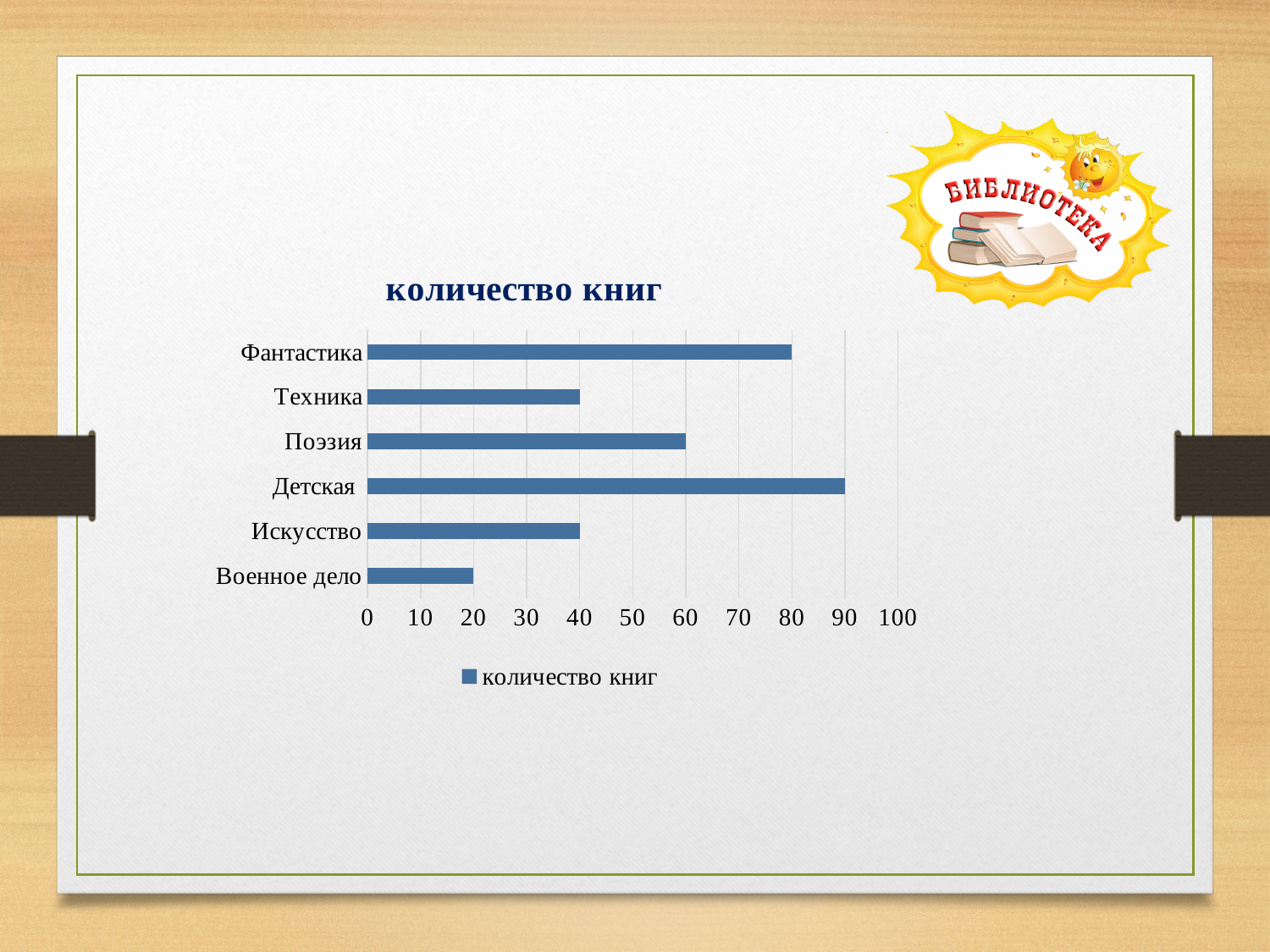
Which category has the lowest value? Военное дело Is the value for Поэзия greater or less than 50? greater Which category has the highest value? Детская How many series does the legend list? 1 What is the value for Военное дело? 20 What is the value for Фантастика? 80 What is the title of the chart? количество книг Which is larger, the value for Поэзия or the value for Техника? Поэзия What type of chart is shown on the slide? bar chart What is the difference between the values for Детская and Военное дело? 70 What is the value for Детская? 90 How many categories are shown in the chart? 6